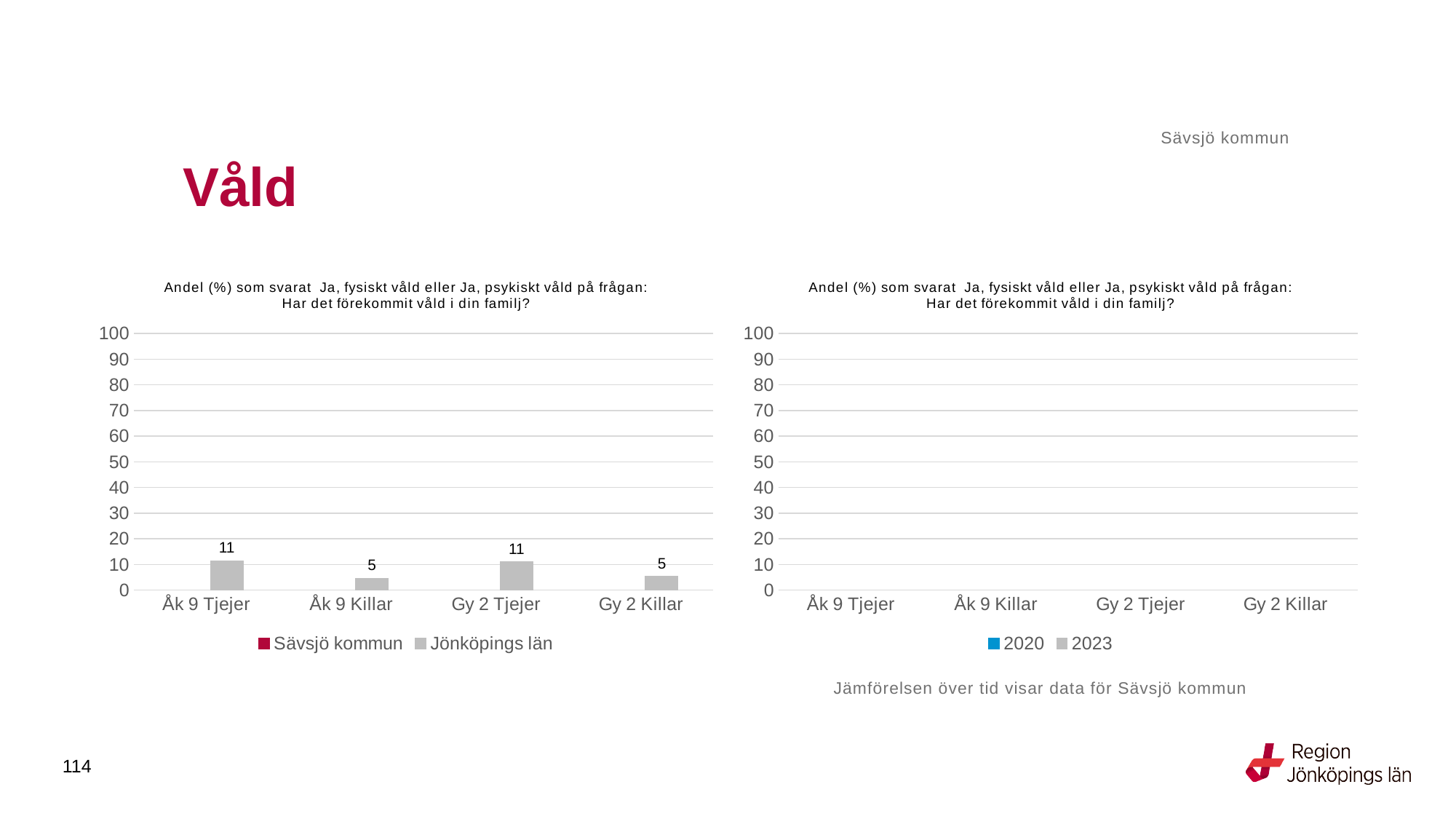
How many series does the legend of the left chart list? 2 On the left chart, what is the value for Jönköpings län for Gy 2 Killar? 5 Which series are listed in the legend of the right chart? 2020 and 2023 On the left chart, what is the value for Jönköpings län for Gy 2 Tjejer? 11 What kind of chart is the left chart? bar chart On the left chart, what is the value for Jönköpings län for Åk 9 Killar? 5 On the left chart, what is the difference between the Jönköpings län values for Åk 9 Tjejer and Åk 9 Killar? 6 How many categories are shown on the x axis of the left chart? 4 On the left chart, which is larger for Jönköpings län: Gy 2 Tjejer or Gy 2 Killar? Gy 2 Tjejer On the left chart, is the Jönköpings län value for Åk 9 Tjejer greater or less than 20? less On the left chart, which series is shown in grey? Jönköpings län On the left chart, what is the value for Jönköpings län for Åk 9 Tjejer? 11